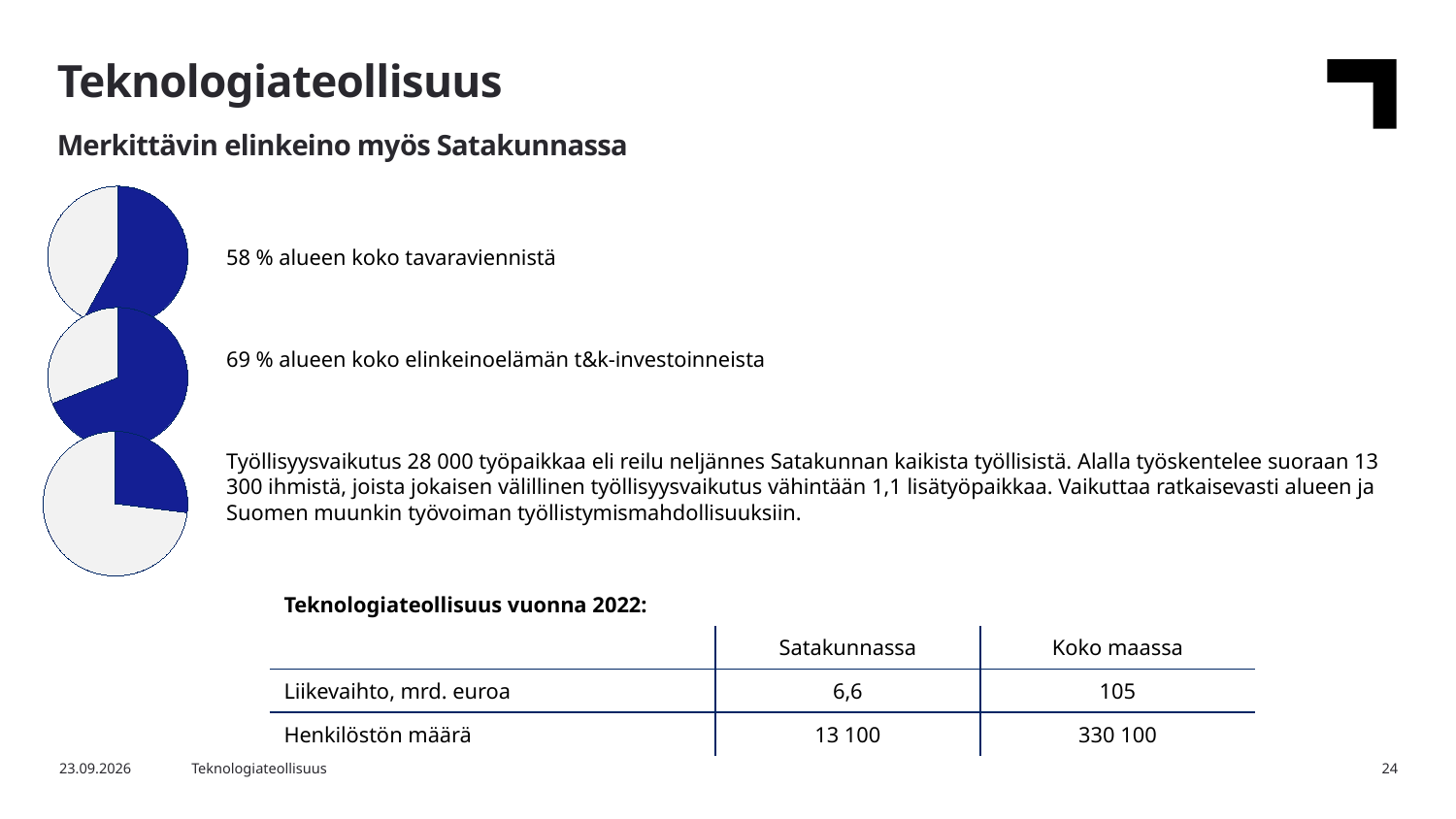
In the middle pie chart, is the blue slice's share greater or less than 50%? greater What kind of chart is the top chart on the left side of the slide? pie chart How many pie charts are shown on the left side of the slide? 3 In the top pie chart, what share does the blue slice represent according to the text beside it? 58 % In the middle pie chart, which slice is larger, the blue one or the grey one? blue In the bottom pie chart, is the blue slice's share greater or less than 50%? less How many slices does the top pie chart have? 2 In the top pie chart, which slice is larger, the blue one or the grey one? blue In the middle pie chart, what share does the blue slice represent according to the text beside it? 69 % Which of the three pie charts has the smallest blue slice: top, middle or bottom? bottom In the bottom pie chart, which slice is larger, the blue one or the grey one? grey Which of the three pie charts has the largest blue slice: top, middle or bottom? middle